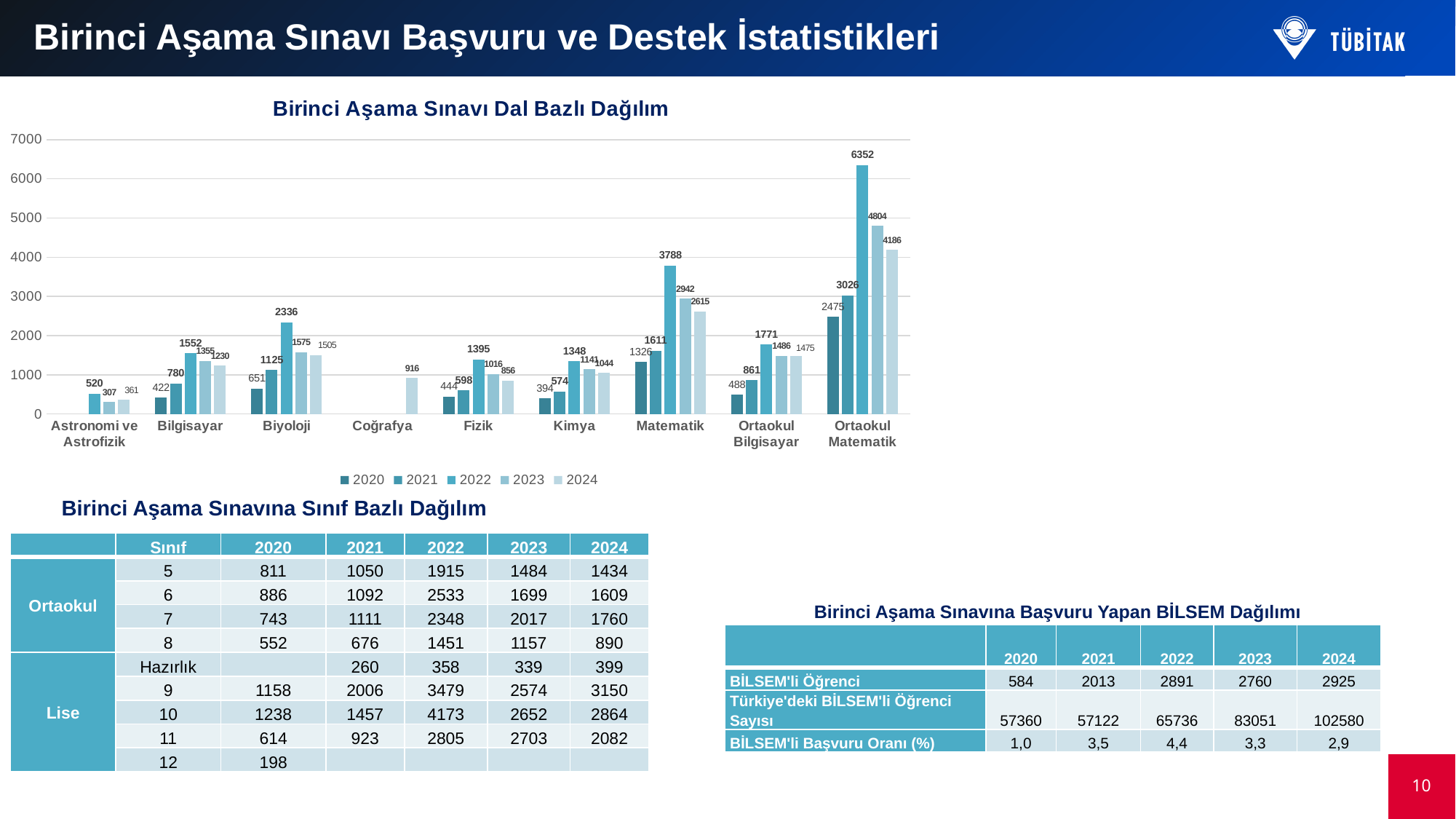
In the "Birinci Aşama Sınavı Dal Bazlı Dağılım" chart, what is the value for Biyoloji in 2020? 651 In the "Birinci Aşama Sınavı Dal Bazlı Dağılım" chart, what is the difference between the 2022 and 2023 values for Matematik? 846 In the "Birinci Aşama Sınavı Dal Bazlı Dağılım" chart, what is the value for Matematik in 2024? 2615 In the "Birinci Aşama Sınavı Dal Bazlı Dağılım" chart, which category has the lowest 2020 value? Kimya How many categories are shown on the x axis of the "Birinci Aşama Sınavı Dal Bazlı Dağılım" chart? 9 In the "Birinci Aşama Sınavı Dal Bazlı Dağılım" chart, do the values for Bilgisayar rise or fall from 2022 to 2024? fall In the "Birinci Aşama Sınavı Dal Bazlı Dağılım" chart, what is the value for Ortaokul Matematik in 2022? 6352 What kind of chart is "Birinci Aşama Sınavı Dal Bazlı Dağılım"? bar chart In the "Birinci Aşama Sınavı Dal Bazlı Dağılım" chart, which category has the highest 2022 value? Ortaokul Matematik In the "Birinci Aşama Sınavı Dal Bazlı Dağılım" chart, which is larger: Fizik in 2022 or Kimya in 2022? Fizik in 2022 In the "Birinci Aşama Sınavı Dal Bazlı Dağılım" chart, is the 2023 value for Ortaokul Matematik greater or less than 4000? greater How many series does the legend of the "Birinci Aşama Sınavı Dal Bazlı Dağılım" chart list? 5